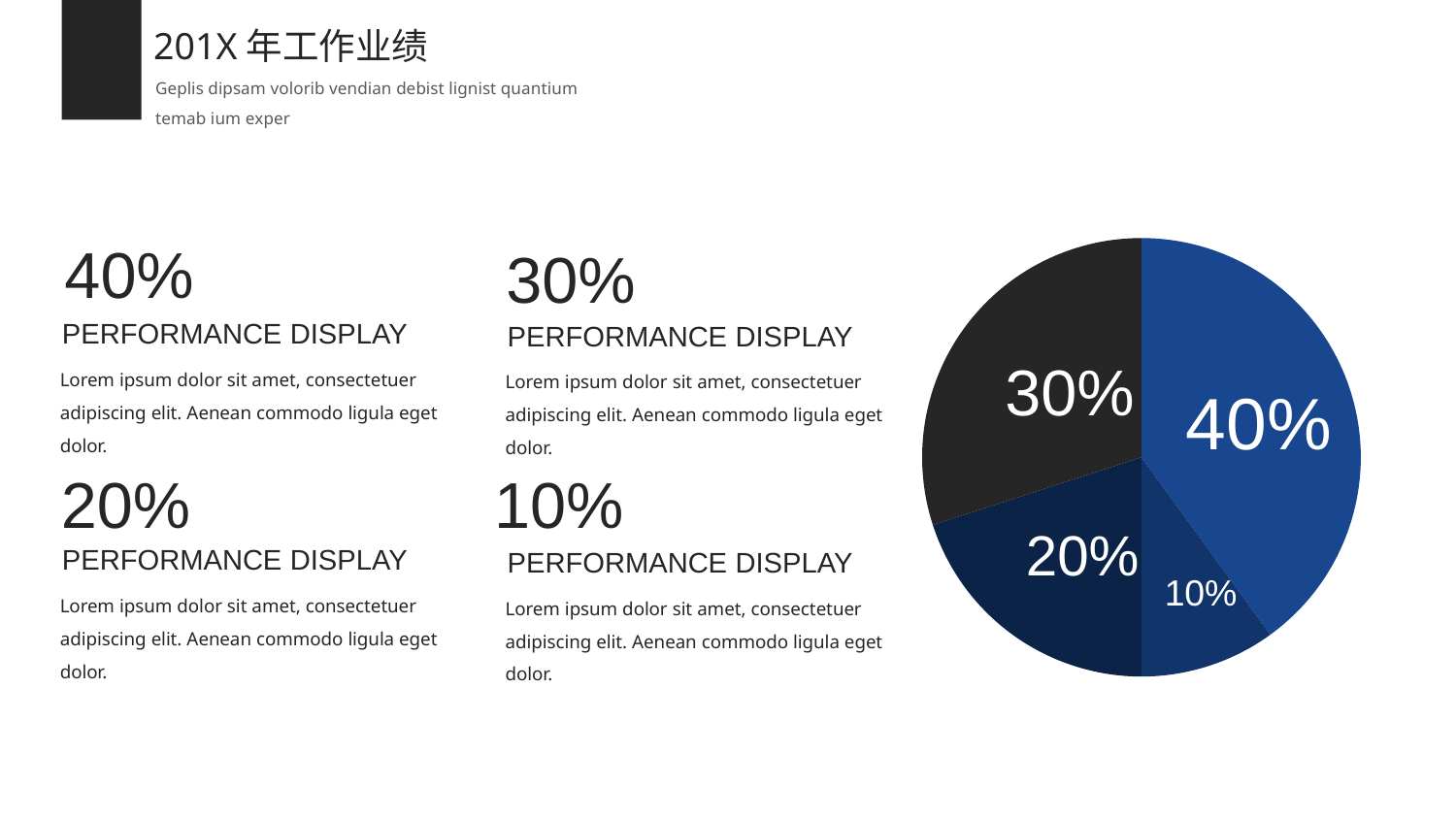
What is the value of the smallest slice in the pie chart? 10% What colour is the 10% slice of the pie chart? blue What kind of chart is shown on the right side of the slide? pie chart What is the difference between the largest and smallest slices in the pie chart? 30% What value is shown on the black slice of the pie chart? 30% What is the value of the largest slice in the pie chart? 40% What value is shown on the dark navy slice at the bottom left of the pie chart? 20% What value is shown on the bright blue slice on the right of the pie chart? 40% What do the four slices of the pie chart add up to? 100% Which is larger in the pie chart, the black slice or the dark navy slice? the black slice How many slices does the pie chart have? 4 What is the difference between the 30% slice and the 20% slice in the pie chart? 10%